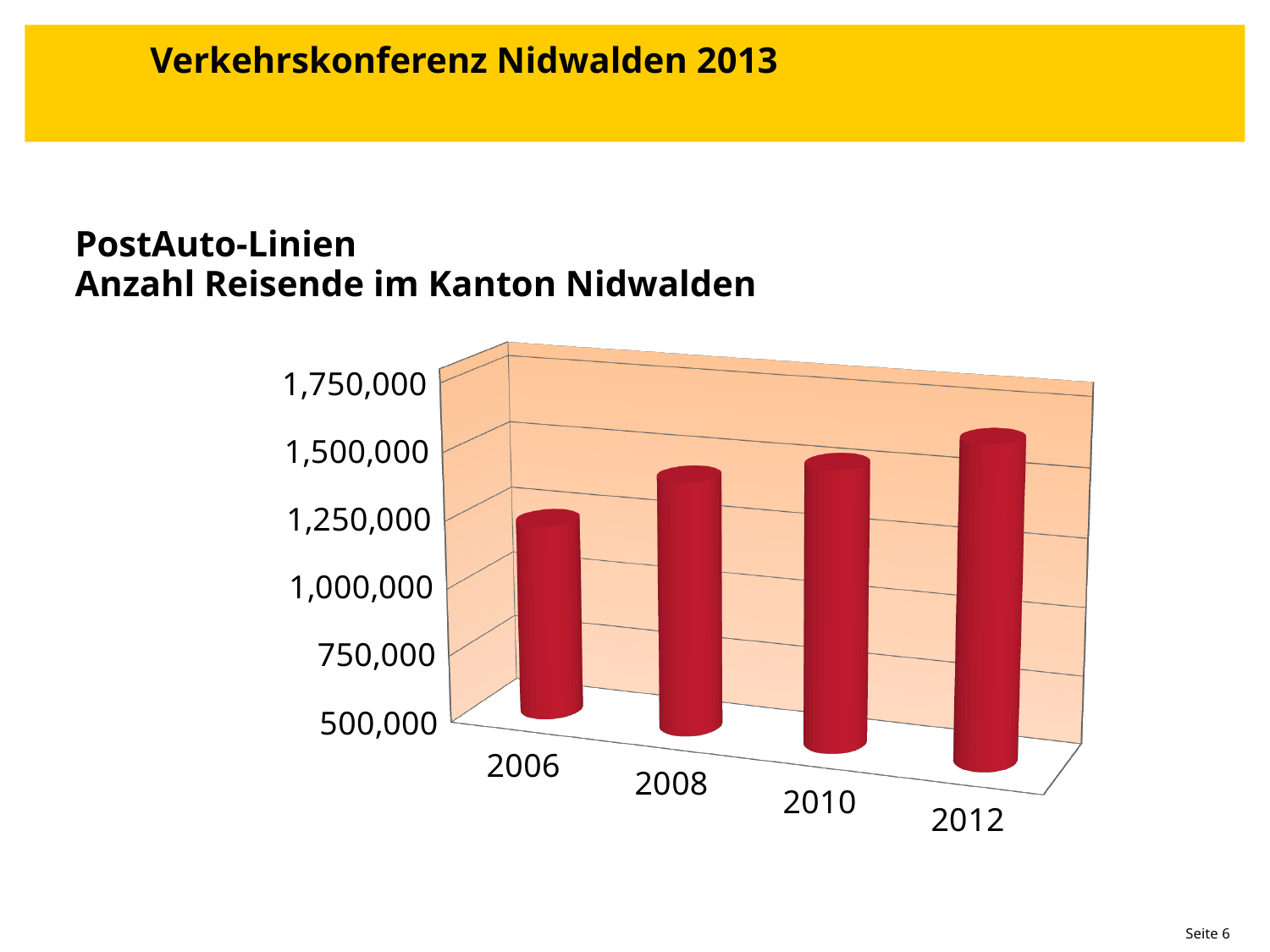
Which year has more passengers, 2006 or 2008? 2008 Is the value for 2006 greater or less than 1,000,000? greater Do the values rise or fall from 2006 to 2012? rise Which year has the highest number of passengers in the chart? 2012 Is the value for 2008 greater or less than 1,250,000? greater Which year has the lowest number of passengers in the chart? 2006 What kind of chart is shown on the slide? bar chart How many years are shown on the x axis of the chart? 4 What is the title of the chart on the slide? PostAuto-Linien Anzahl Reisende im Kanton Nidwalden Is the value for 2012 greater or less than 1,250,000? greater Which year has more passengers, 2006 or 2012? 2012